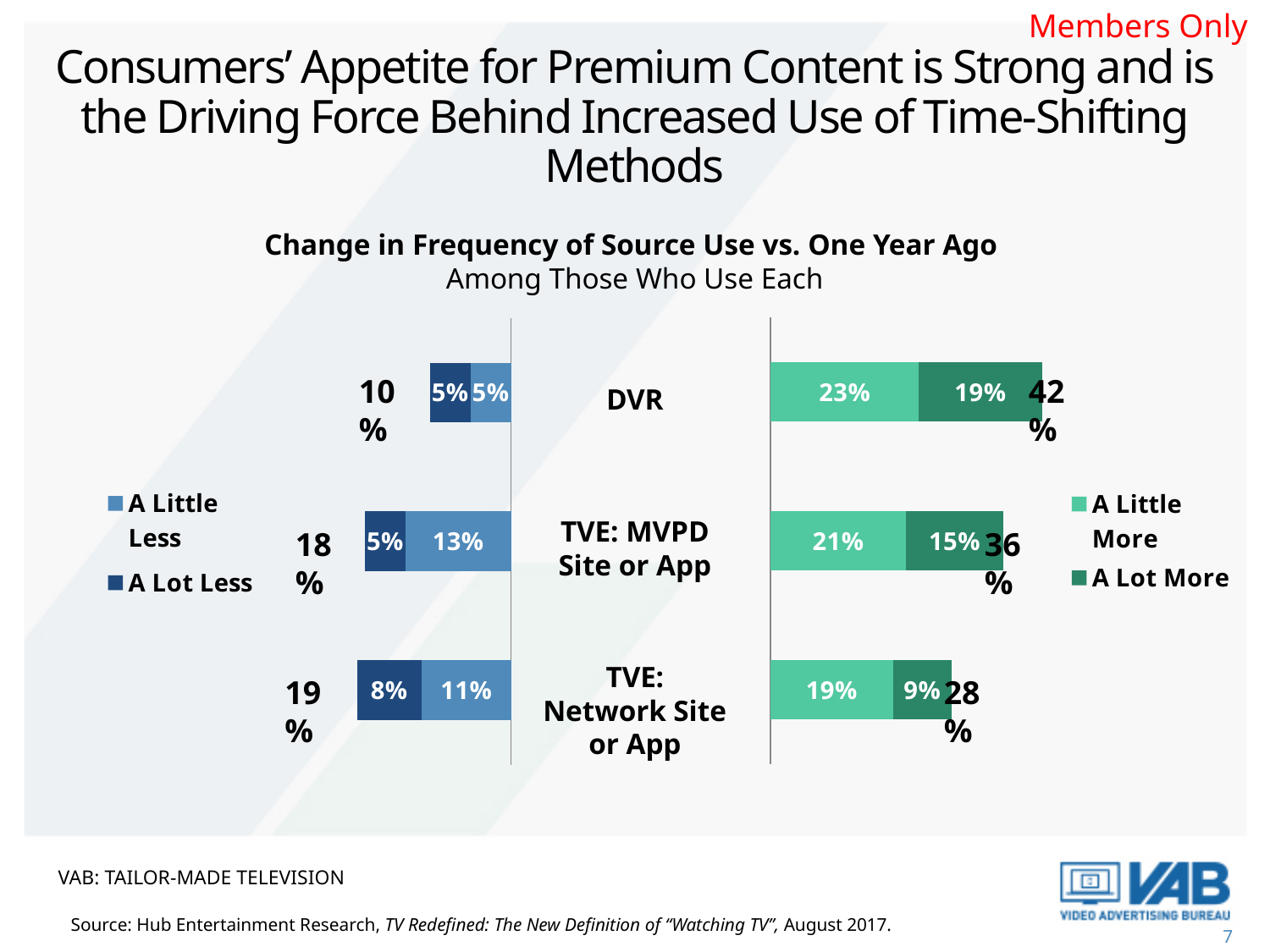
In the right-hand chart, which source has the lowest 'A Little More' value? TVE: Network Site or App In the left-hand chart, which is larger: the 'A Little Less' value for TVE: MVPD Site or App or for DVR? TVE: MVPD Site or App In the right-hand chart, what is the total of the stacked bar for DVR? 42% In the right-hand chart (A Little More / A Lot More), what is the 'A Little More' value for DVR? 23% In the left-hand chart, what is the total of the stacked bar for TVE: Network Site or App? 19% What type of chart is used on this slide? Bar chart In the right-hand chart, what is the 'A Lot More' value for TVE: MVPD Site or App? 15% In the right-hand chart, what is the difference between the 'A Little More' values for DVR and TVE: Network Site or App? 4% In the right-hand chart, which source has the highest 'A Lot More' value? DVR How many sources (categories) are shown in each chart? 3 In the left-hand chart (A Little Less / A Lot Less), what is the 'A Little Less' value for TVE: Network Site or App? 11% In the left-hand chart, what is the 'A Lot Less' value for TVE: MVPD Site or App? 5%